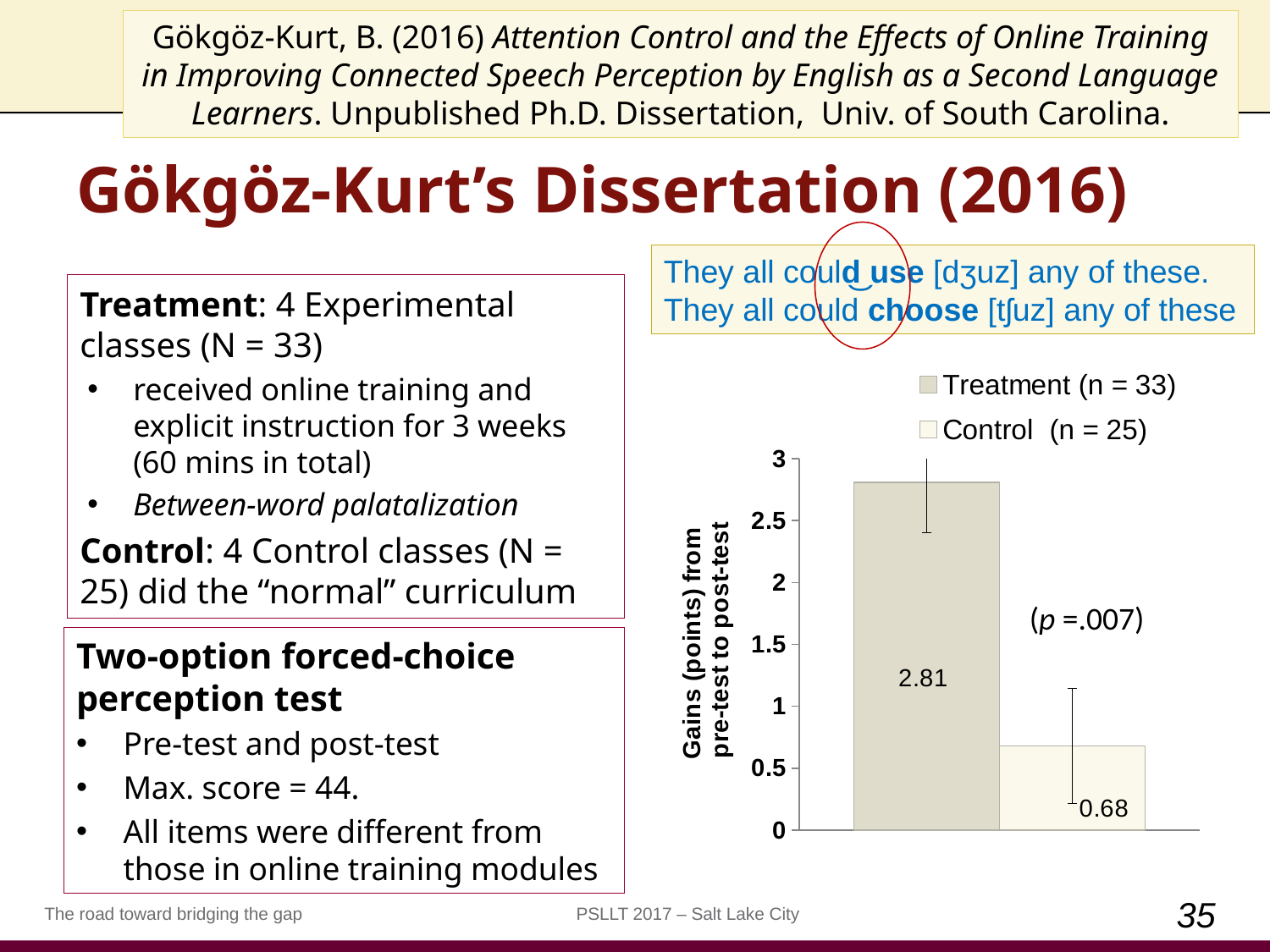
What kind of chart is shown on the slide? bar chart What is the gain value for the Control group? 0.68 Which group has the lower gain from pre-test to post-test? Control (n = 25) What is the label of the vertical axis of the chart? Gains (points) from pre-test to post-test What is the difference in gains between the Treatment and Control groups? 2.13 How many series does the legend list? 2 Is the gain for the Control group greater or less than 1? less Which group has the higher gain from pre-test to post-test? Treatment (n = 33) Is the gain for the Treatment group greater or less than 2.5? greater How many bars are plotted in the chart? 2 What is the gain value for the Treatment group? 2.81 Is the gain for the Treatment group larger or smaller than the gain for the Control group? larger